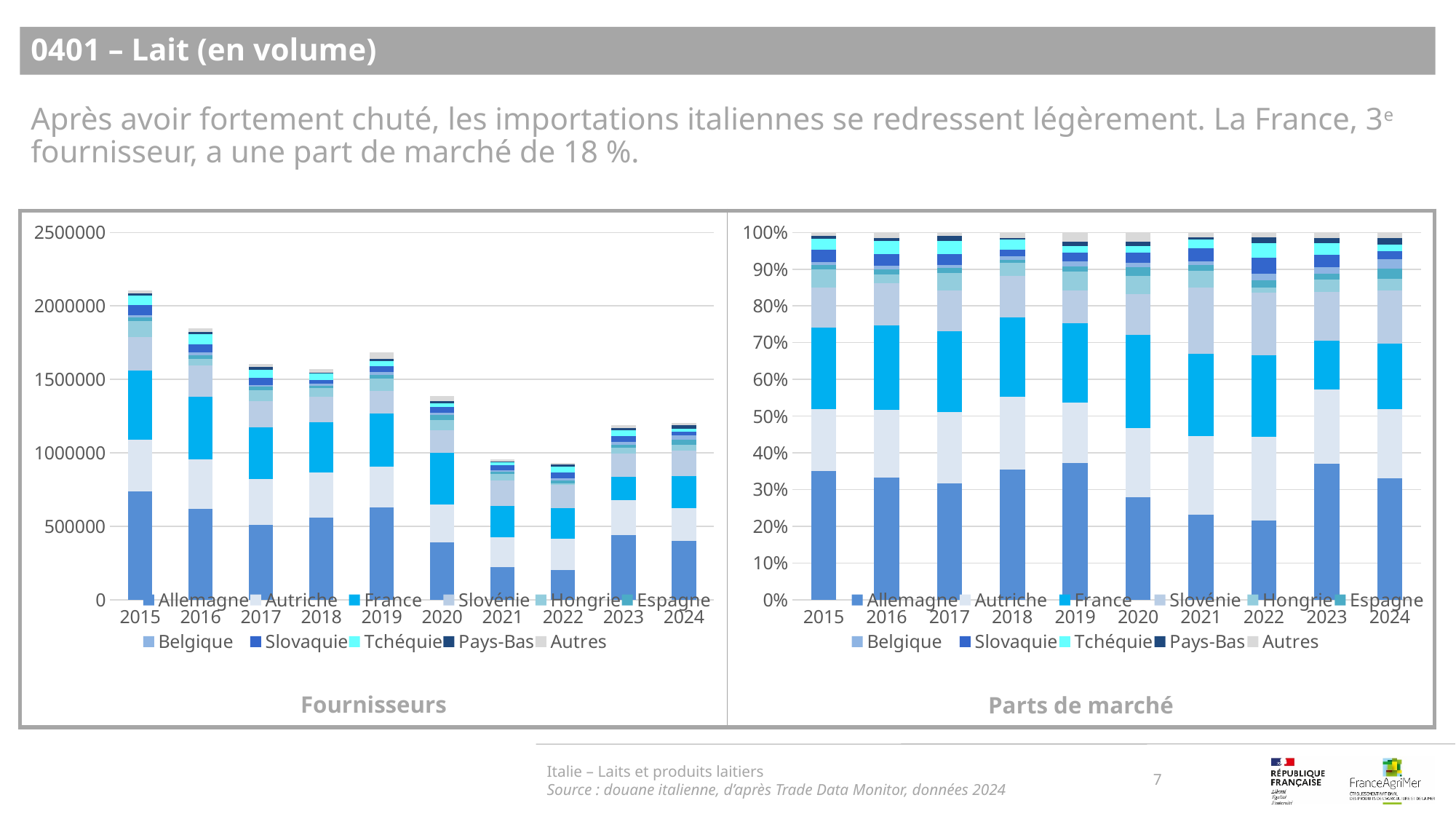
What kind of chart is the 'Fournisseurs' chart on the left? stacked bar chart In the 'Fournisseurs' chart, which total bar is larger, 2015 or 2016? 2015 How many years are shown on the x axis of the 'Fournisseurs' chart? 10 What is the title of the chart on the right of the slide? Parts de marché In the 'Fournisseurs' chart, do the total bars generally rise or fall from 2015 to 2022? fall In the 'Fournisseurs' chart, which year has the tallest total bar? 2015 In the 'Parts de marché' chart, is the Allemagne share in 2019 greater or less than 30%? greater In the 'Fournisseurs' chart, is the total bar for 2015 greater or less than 2000000? greater How many series does the legend of the 'Parts de marché' chart list? 11 In the 'Fournisseurs' chart, is the total bar for 2021 greater or less than 1000000? less In the 'Parts de marché' chart, which year has the larger Allemagne share, 2020 or 2023? 2023